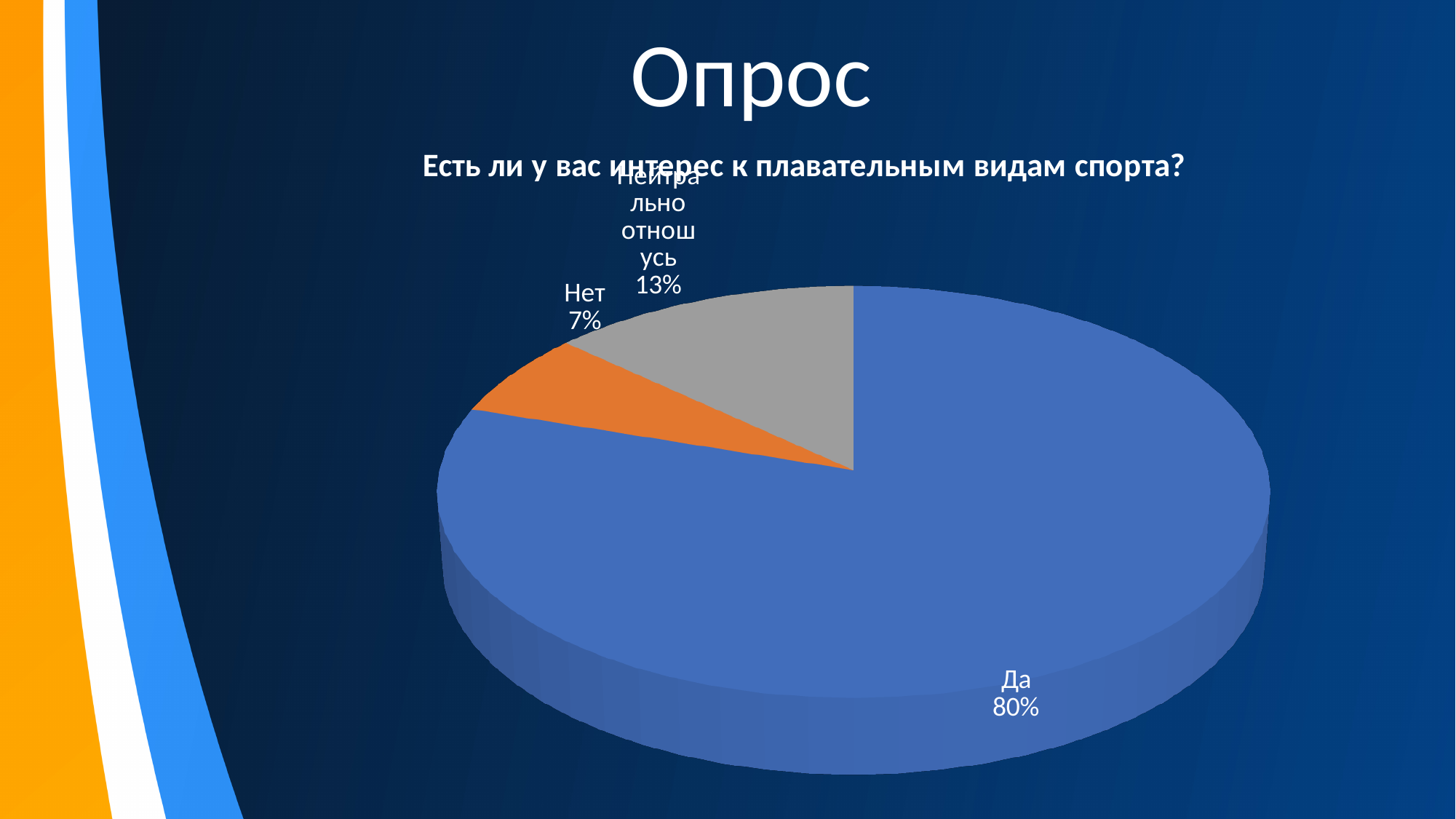
How many slices does the pie chart have? 3 What is the difference between the shares for "Нейтрально отношусь" and "Нет"? 6% What is the difference between the shares for "Да" and "Нейтрально отношусь"? 67% What share of the pie does "Да" have? 80% What share of the pie does "Нейтрально отношусь" have? 13% What share of the pie does "Нет" have? 7% Which slice of the pie is the smallest? Нет What colour is the "Нет" slice? orange Which slice of the pie is the largest? Да Which is larger, the share for "Нет" or the share for "Нейтрально отношусь"? Нейтрально отношусь What kind of chart is shown on the slide? pie chart What is the title of the chart? Есть ли у вас интерес к плавательным видам спорта?